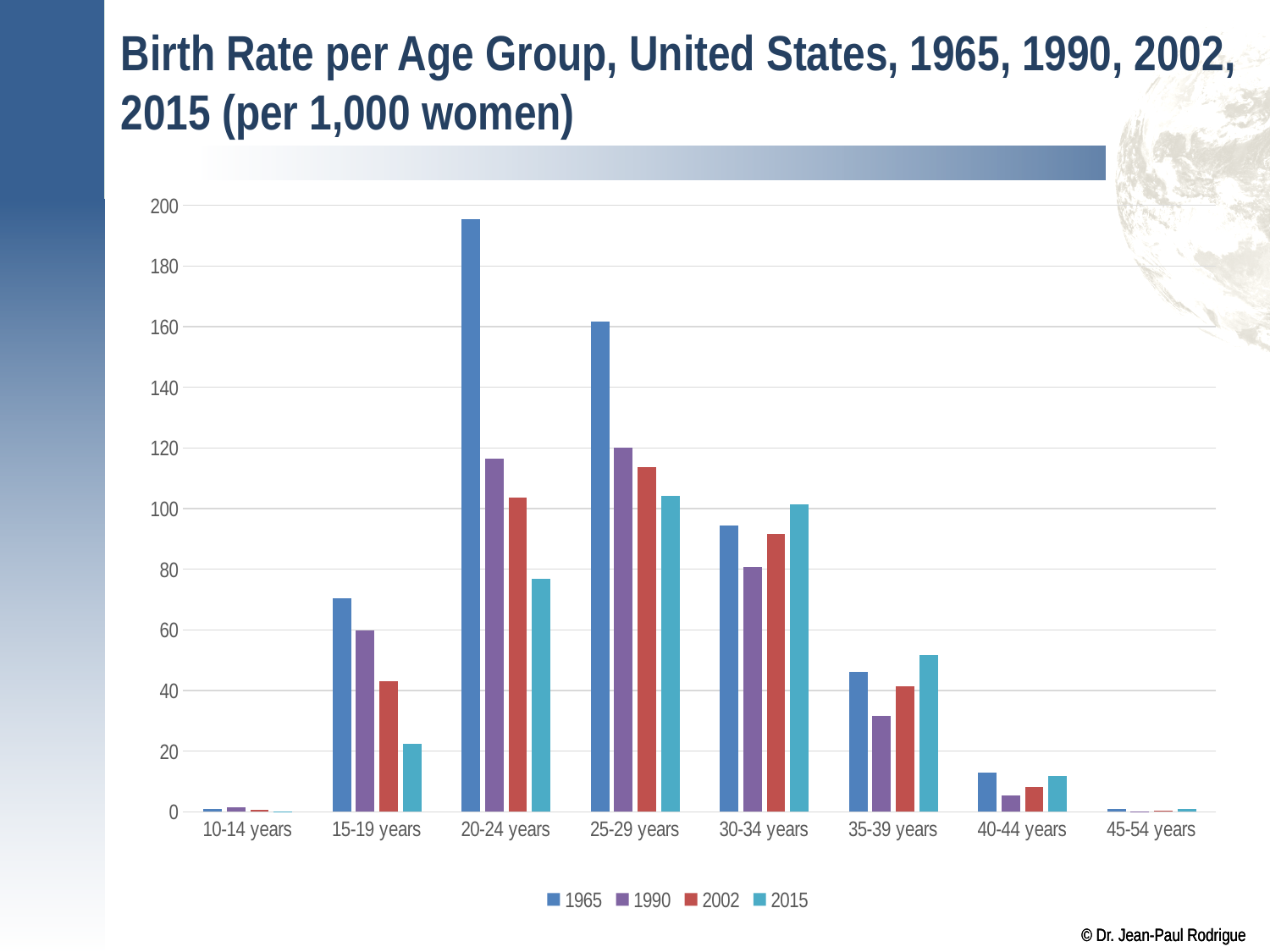
Is the 1965 value for 20-24 years greater or less than 180? greater For 30-34 years, which is larger: the 1965 value or the 2015 value? 2015 Is the 2015 value for 15-19 years greater or less than 40? less For 20-24 years, do the values rise or fall from 1965 to 2015? fall What colour represents the 2002 series in the legend? Red What kind of chart is shown on the slide? Bar chart Which age group has the highest birth rate for 1965? 20-24 years How many series does the legend list? 4 Which year has the lowest value for 40-44 years? 1990 How many age groups are shown on the x axis? 8 Is the 1990 value for 25-29 years greater or less than 100? greater For 15-19 years, which is larger: the 1965 value or the 2015 value? 1965